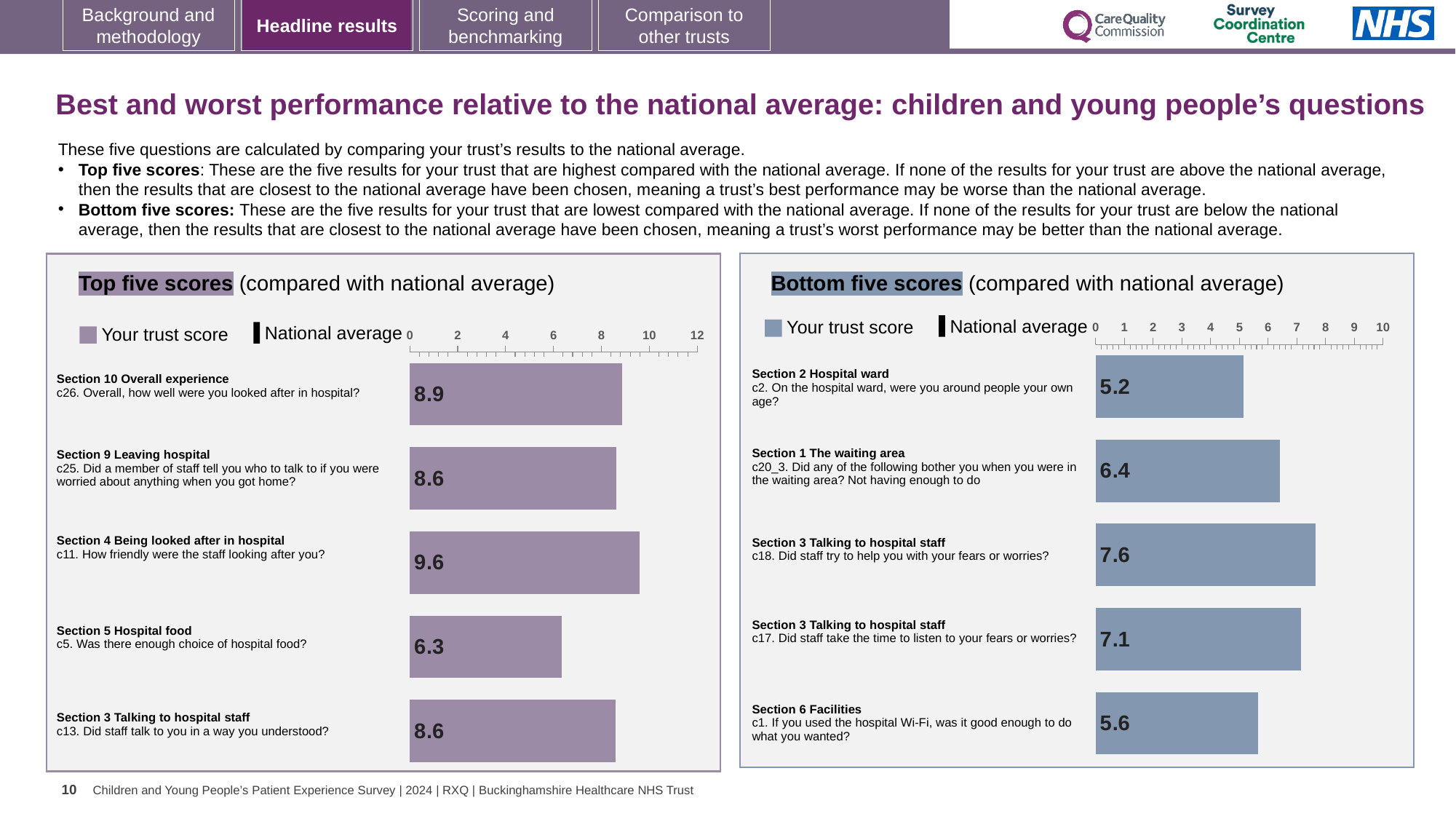
In the Bottom five scores chart, what is the difference between the scores for c17 and c2? 1.9 In the Bottom five scores chart, which question has the lowest trust score? c2. On the hospital ward, were you around people your own age? In the Top five scores chart, what is the trust score for c26 (Overall, how well were you looked after in hospital)? 8.9 In the Top five scores chart, how many questions are plotted? 5 In the Bottom five scores chart, which is larger: the score for c20_3 or the score for c1? c20_3 In the Top five scores chart, which question has the highest trust score? c11. How friendly were the staff looking after you? In the Top five scores chart, which question has the lowest trust score? c5. Was there enough choice of hospital food? What kind of chart is the Top five scores chart? Bar chart In the Bottom five scores chart, which question has the highest trust score? c18. Did staff try to help you with your fears or worries? In the Bottom five scores chart, what is the trust score for c18 (Did staff try to help you with your fears or worries)? 7.6 In the Top five scores chart, what is the difference between the scores for c11 and c5? 3.3 How many entries does the legend of the Bottom five scores chart list? 2